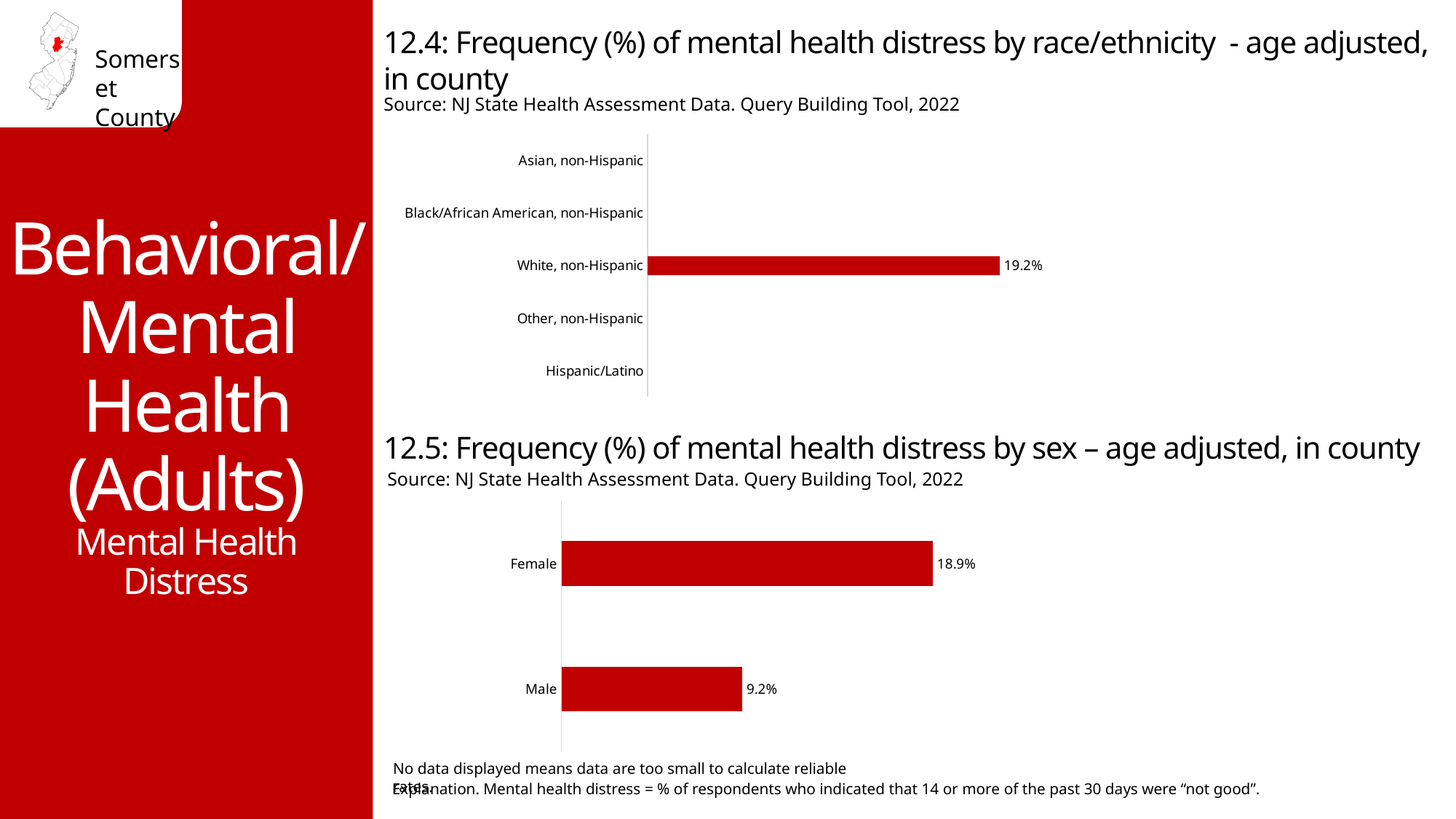
In chart 12.5 (mental health distress by sex), which category has the lowest value? Male What kind of chart is chart 12.4 (mental health distress by race/ethnicity)? Bar chart In chart 12.4 (mental health distress by race/ethnicity), how many race/ethnicity categories are listed on the axis? 5 What kind of chart is chart 12.5 (mental health distress by sex)? Bar chart In chart 12.4 (mental health distress by race/ethnicity), what is the value for White, non-Hispanic? 19.2% In chart 12.5 (mental health distress by sex), what is the value for Female? 18.9% In chart 12.5 (mental health distress by sex), which category has the highest value? Female In chart 12.5 (mental health distress by sex), what is the value for Male? 9.2% In chart 12.5 (mental health distress by sex), how many categories are shown? 2 In chart 12.5 (mental health distress by sex), is the value for Female or Male larger? Female In chart 12.4 (mental health distress by race/ethnicity), which category is the only one with a bar displayed? White, non-Hispanic In chart 12.5 (mental health distress by sex), what is the difference between the Female and Male values? 9.7%